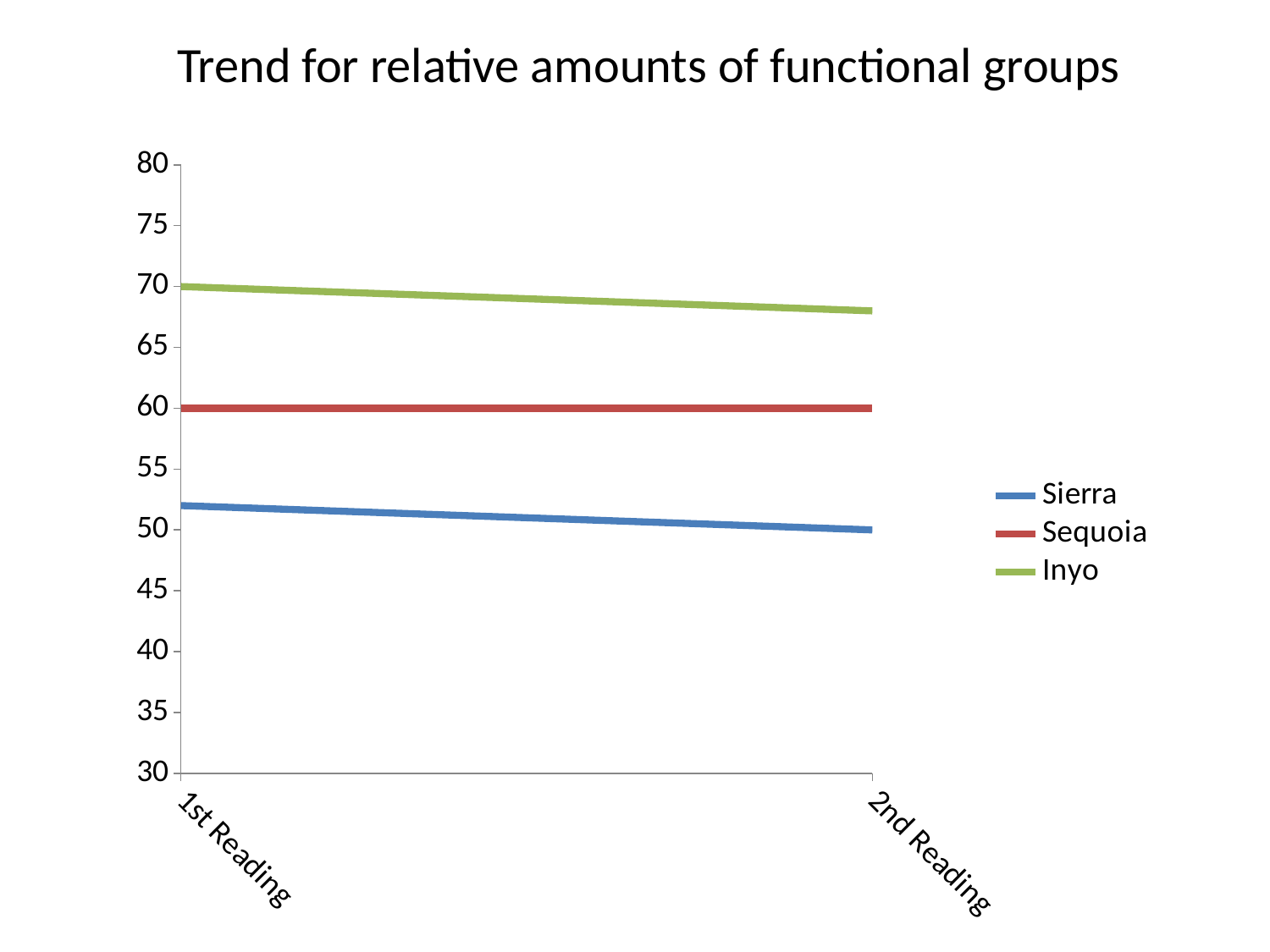
Does the Sierra line rise or fall from the 1st Reading to the 2nd Reading? fall Which series has the lowest value at the 2nd Reading? Sierra What is the value for Sequoia at the 1st Reading? 60 What is the value for Inyo at the 1st Reading? 70 What is the difference between the Inyo and Sequoia values at the 1st Reading? 10 Is the value for Inyo at the 2nd Reading greater or less than 65? greater How many readings are shown along the x axis? 2 What is the title of the chart? Trend for relative amounts of functional groups What kind of chart is shown on the slide? line chart What is the value for Sierra at the 2nd Reading? 50 How many series does the legend list? 3 Which series has the highest value at the 1st Reading? Inyo